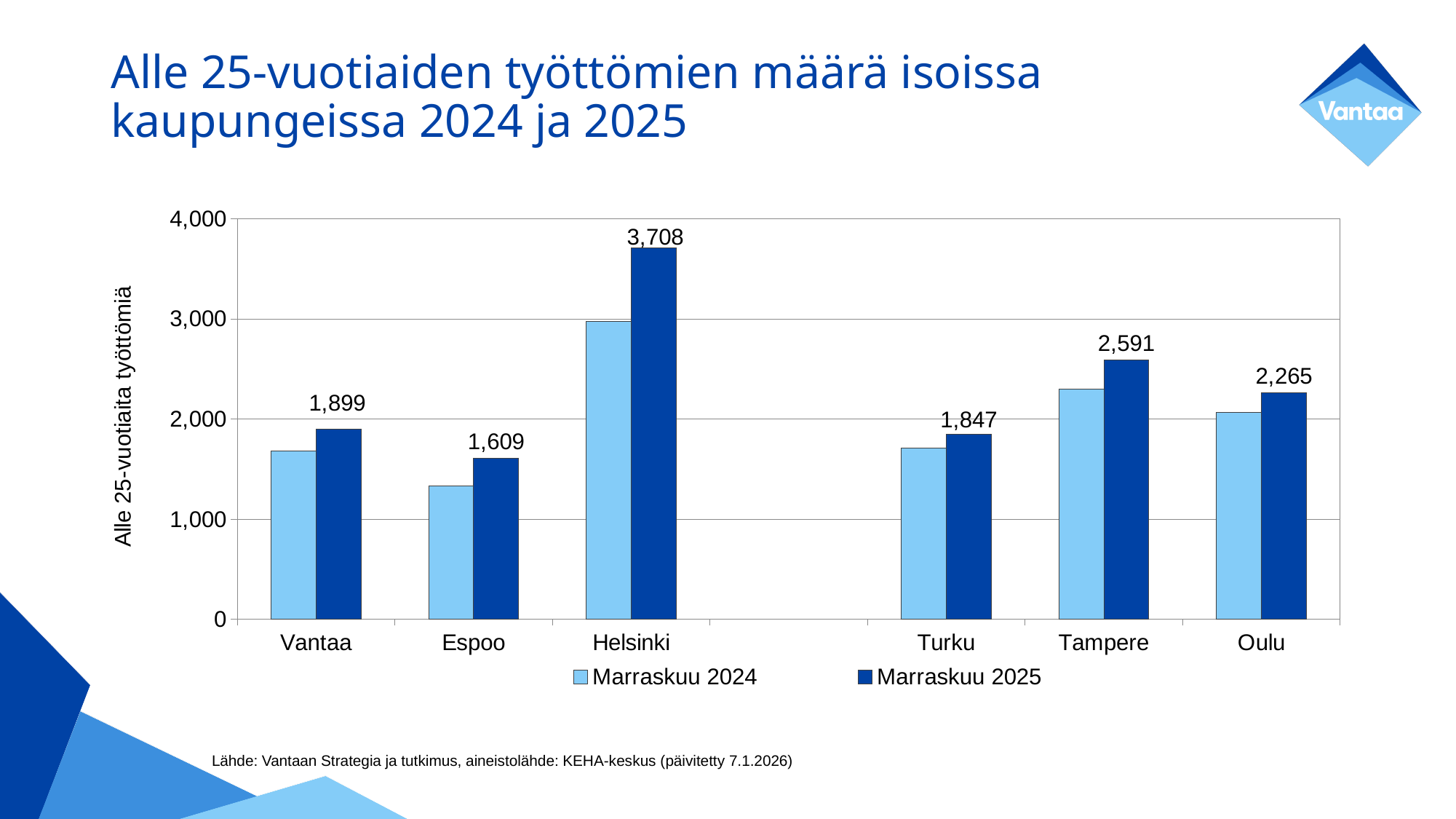
What is the value for Vantaa in the Marraskuu 2025 series? 1,899 Which city has the highest value in the Marraskuu 2025 series? Helsinki Which is larger in the Marraskuu 2025 series, Vantaa or Turku? Vantaa What is the value for Espoo in the Marraskuu 2025 series? 1,609 Is the Marraskuu 2024 value for Vantaa greater or less than 2,000? less How many cities are shown on the x axis? 6 What is the value for Helsinki in the Marraskuu 2025 series? 3,708 What is the difference between the Marraskuu 2025 values for Tampere and Oulu? 326 How many series does the legend list? 2 Which city has the lowest value in the Marraskuu 2025 series? Espoo Is the Marraskuu 2024 value for Espoo greater or less than 1,000? greater What kind of chart is shown on the slide? Bar chart